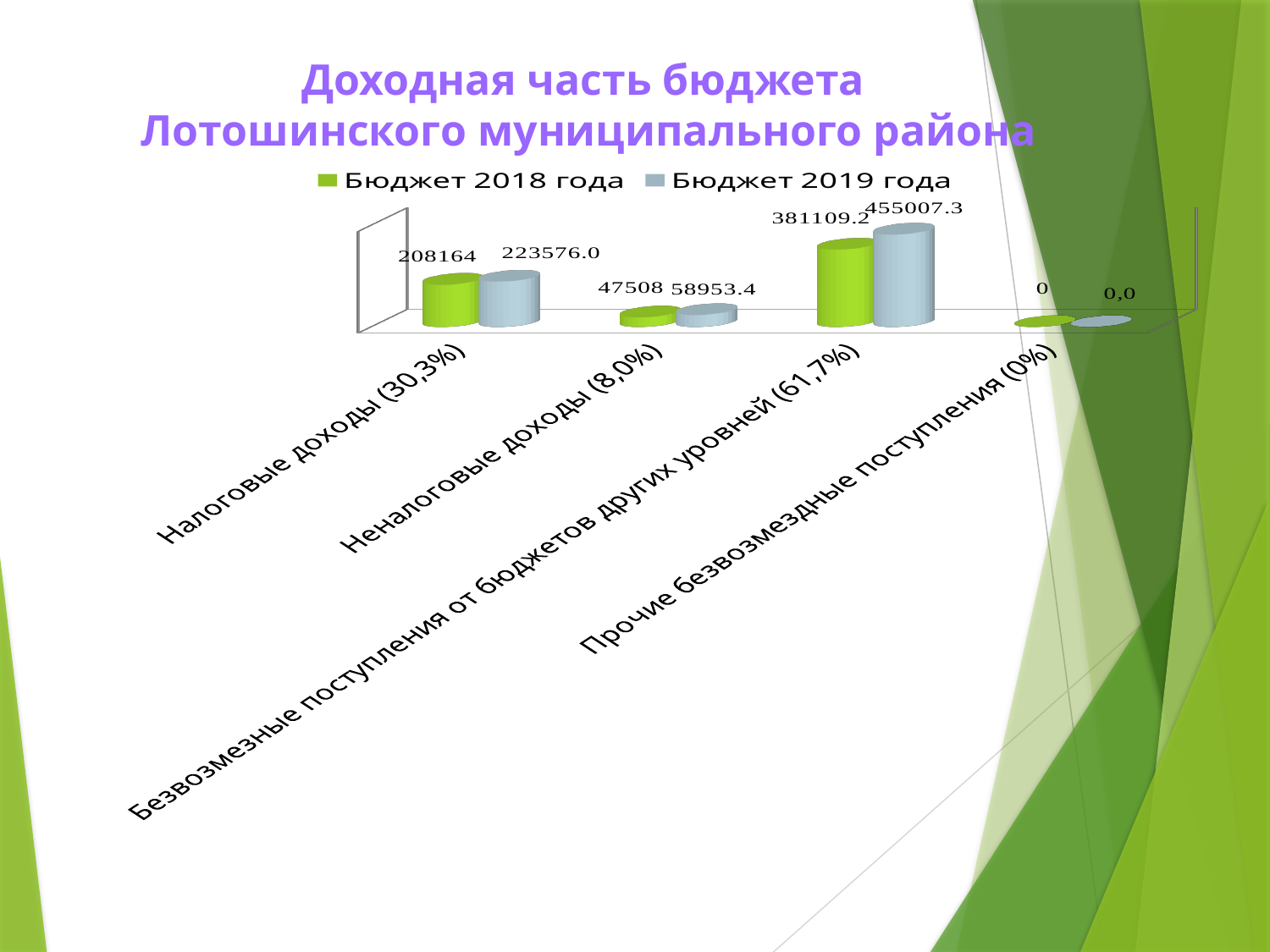
How many categories are shown on the x axis? 4 What is the difference between the Бюджет 2019 года and Бюджет 2018 года values for Неналоговые доходы (8,0%)? 11445.4 What is the value for Неналоговые доходы (8,0%) in the Бюджет 2018 года series? 47508 What is the value for Неналоговые доходы (8,0%) in the Бюджет 2019 года series? 58953.4 Which category has the lowest value in the Бюджет 2019 года series? Прочие безвозмездные поступления (0%) Which category has the highest value in the Бюджет 2018 года series? Безвозмездные поступления от бюджетов других уровней (61,7%) What kind of chart is shown on the slide? Bar chart How many series does the legend list? 2 What is the value for Безвозмездные поступления от бюджетов других уровней (61,7%) in the Бюджет 2019 года series? 455007.3 What is the value for Налоговые доходы (30,3%) in the Бюджет 2019 года series? 223576.0 What is the value for Налоговые доходы (30,3%) in the Бюджет 2018 года series? 208164 Which is larger for Безвозмездные поступления от бюджетов других уровней (61,7%): the Бюджет 2018 года value or the Бюджет 2019 года value? Бюджет 2019 года